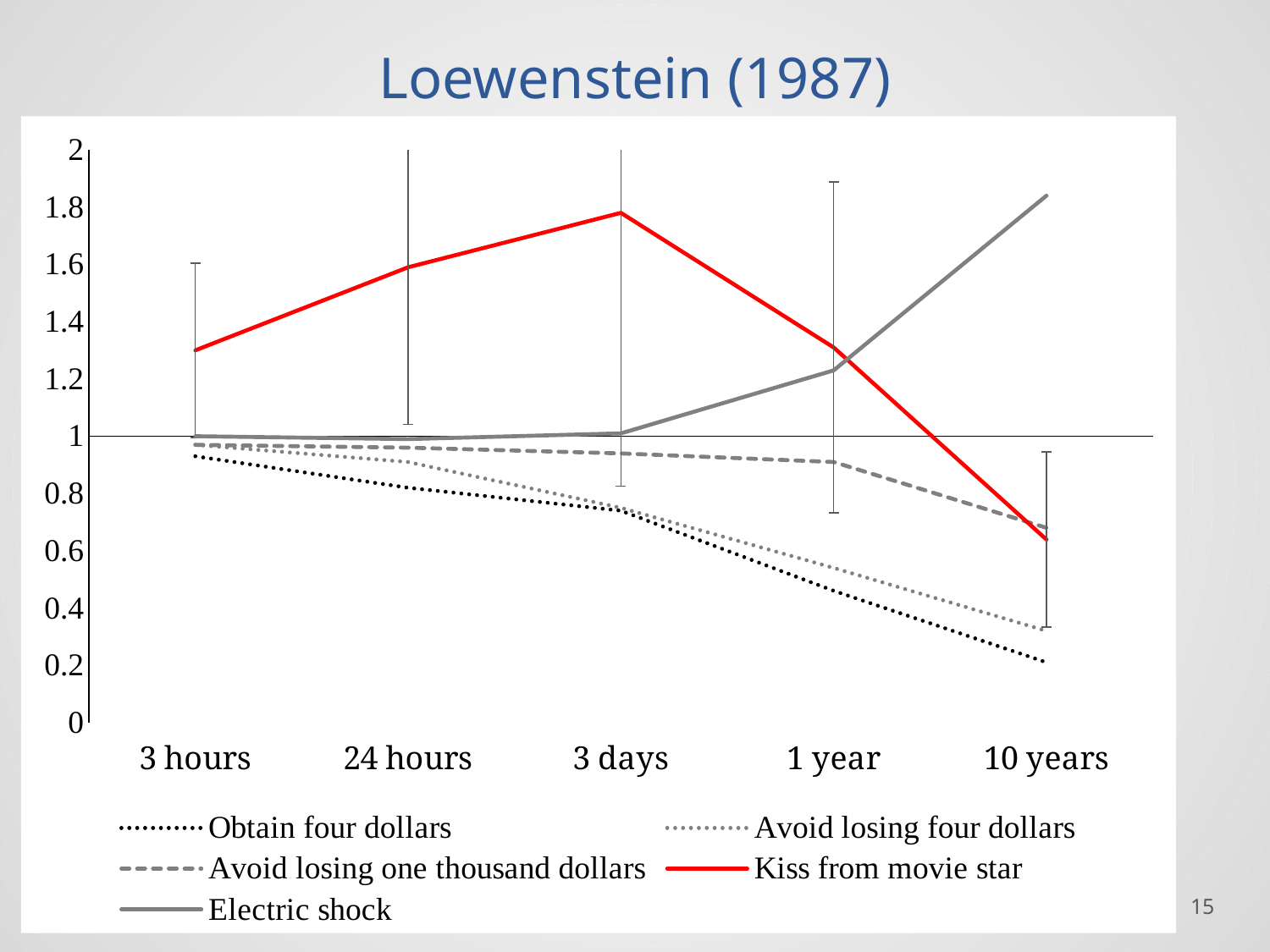
Which series has the lowest value at 10 years? Obtain four dollars Is the value for Obtain four dollars at 1 year greater or less than 0.6? less At 3 days, which is larger: Kiss from movie star or Electric shock? Kiss from movie star How many series does the legend list? 5 What kind of chart is shown on the slide? line chart Which series has the highest value at 3 days? Kiss from movie star How many time-delay categories are shown on the x axis? 5 Which series has the highest value at 10 years? Electric shock Does the Obtain four dollars series rise or fall from 3 hours to 10 years? fall Is the value for Kiss from movie star at 3 days greater or less than 1.6? greater Is the value for Kiss from movie star at 10 years greater or less than 0.8? less What is the title of the slide? Loewenstein (1987)